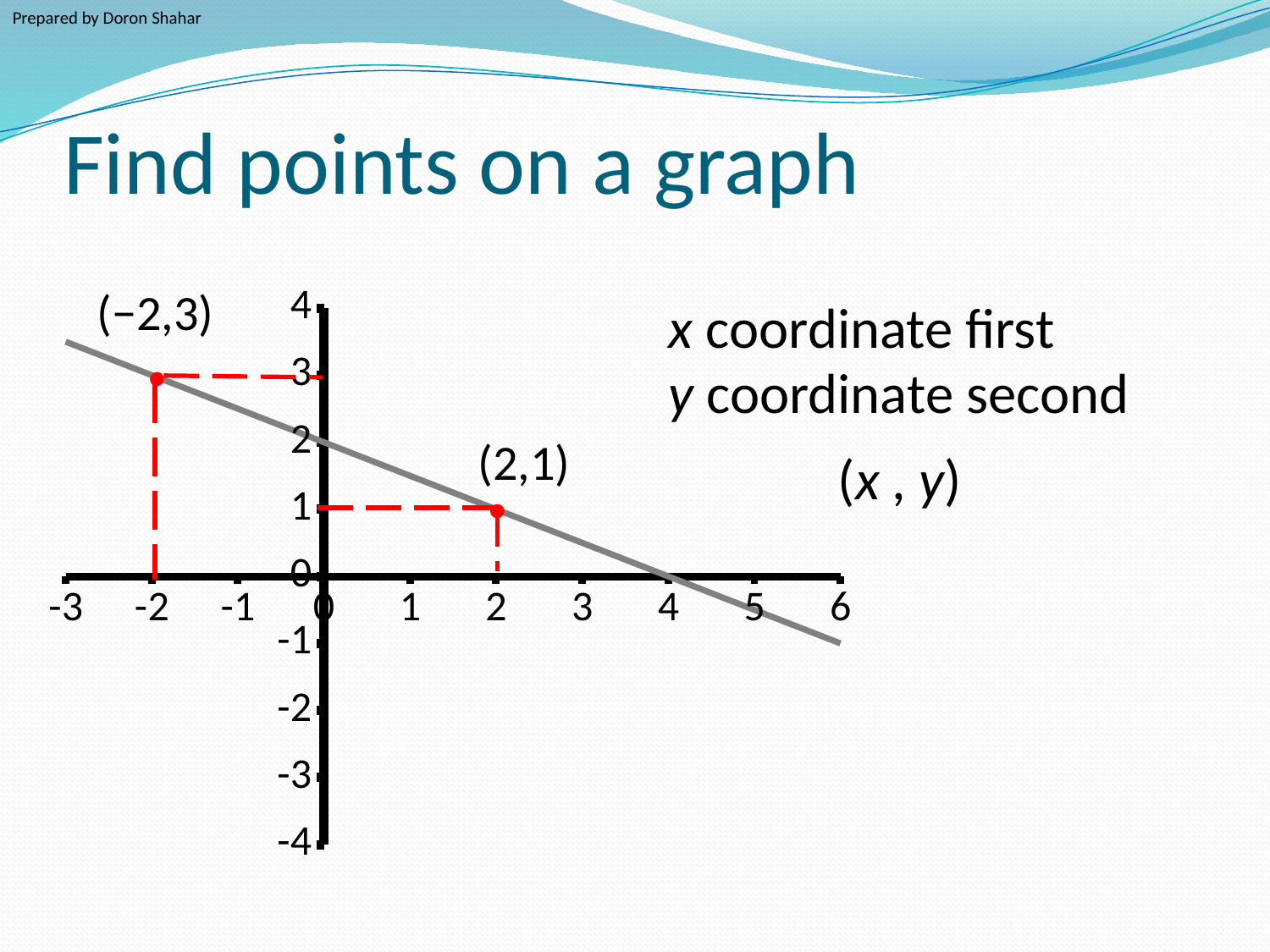
At what x value does the line cross the x-axis? 4 At what y value does the line cross the y-axis? 2 Does the plotted line rise or fall as x increases? fall What is the x-coordinate of the marked point labeled (2,1)? 2 What is the largest value labeled on the x-axis? 6 At x = 5, is the value of the line greater or less than 0? less What kind of chart is shown on the slide? line graph Which marked point has the larger y-coordinate, (-2,3) or (2,1)? (-2,3) How many points are marked with red dots on the graph? 2 What is the difference between the y-coordinates of the points (-2,3) and (2,1)? 2 What is the y-coordinate of the marked point at x = -2? 3 What colour are the dashed guide lines connecting the marked points to the axes? red